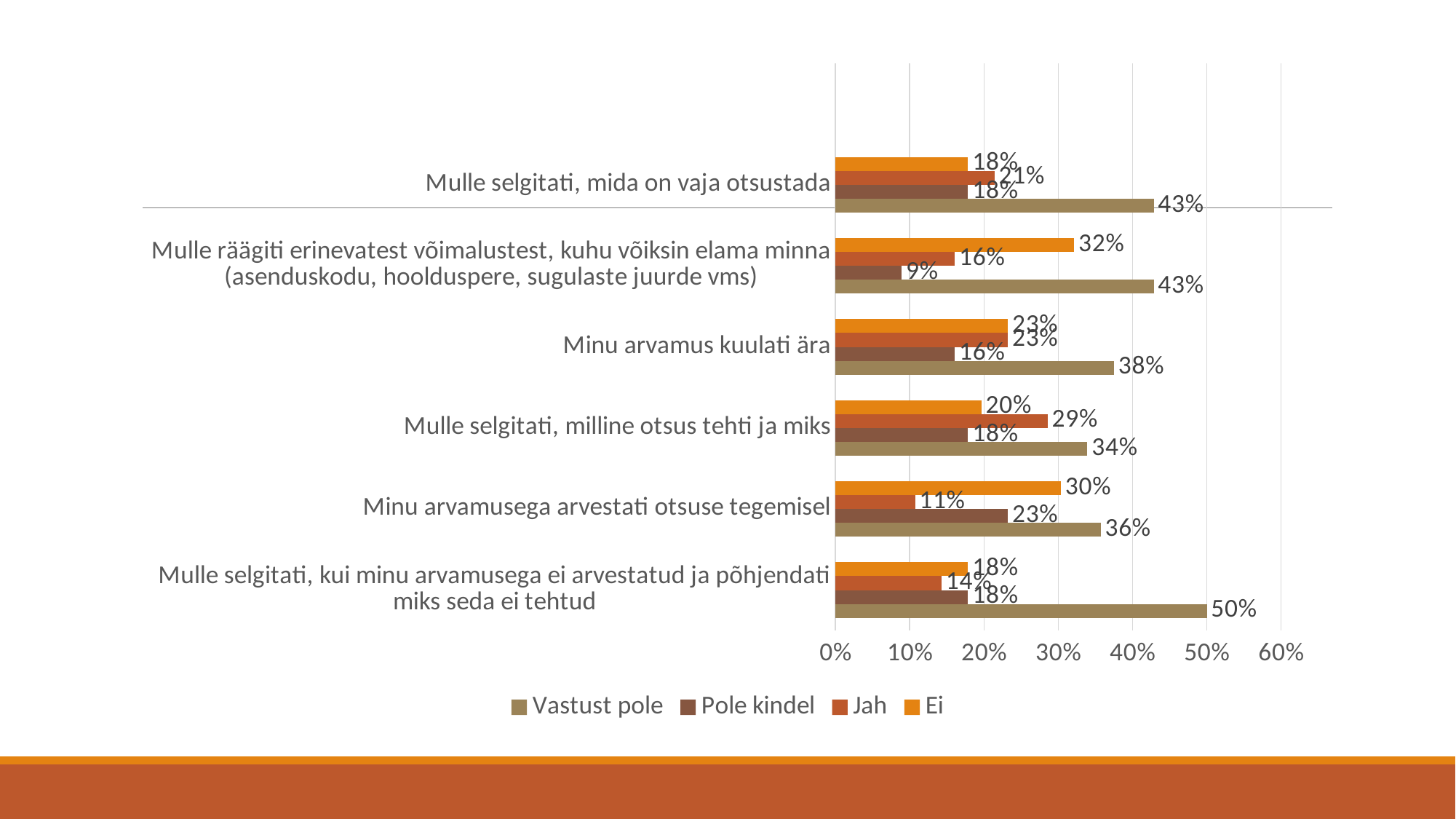
What is the value of "Ei" for "Mulle räägiti erinevatest võimalustest, kuhu võiksin elama minna (asenduskodu, hoolduspere, sugulaste juurde vms)"? 32% What kind of chart is shown on the slide? bar chart Which category has the highest "Vastust pole" value? Mulle selgitati, kui minu arvamusega ei arvestatud ja põhjendati miks seda ei tehtud What is the value of "Pole kindel" for "Minu arvamusega arvestati otsuse tegemisel"? 23% What is the value of "Jah" for "Mulle selgitati, milline otsus tehti ja miks"? 29% How many categories are shown on the chart? 6 Which category has the lowest "Pole kindel" value? Mulle räägiti erinevatest võimalustest, kuhu võiksin elama minna (asenduskodu, hoolduspere, sugulaste juurde vms) How many series does the legend list? 4 Which series is shown in the lightest tan colour in the legend? Vastust pole What is the difference between the "Ei" and "Jah" values for "Minu arvamusega arvestati otsuse tegemisel"? 19% For "Mulle selgitati, milline otsus tehti ja miks", which is larger: "Jah" or "Ei"? Jah What is the value of "Vastust pole" for "Mulle selgitati, kui minu arvamusega ei arvestatud ja põhjendati miks seda ei tehtud"? 50%